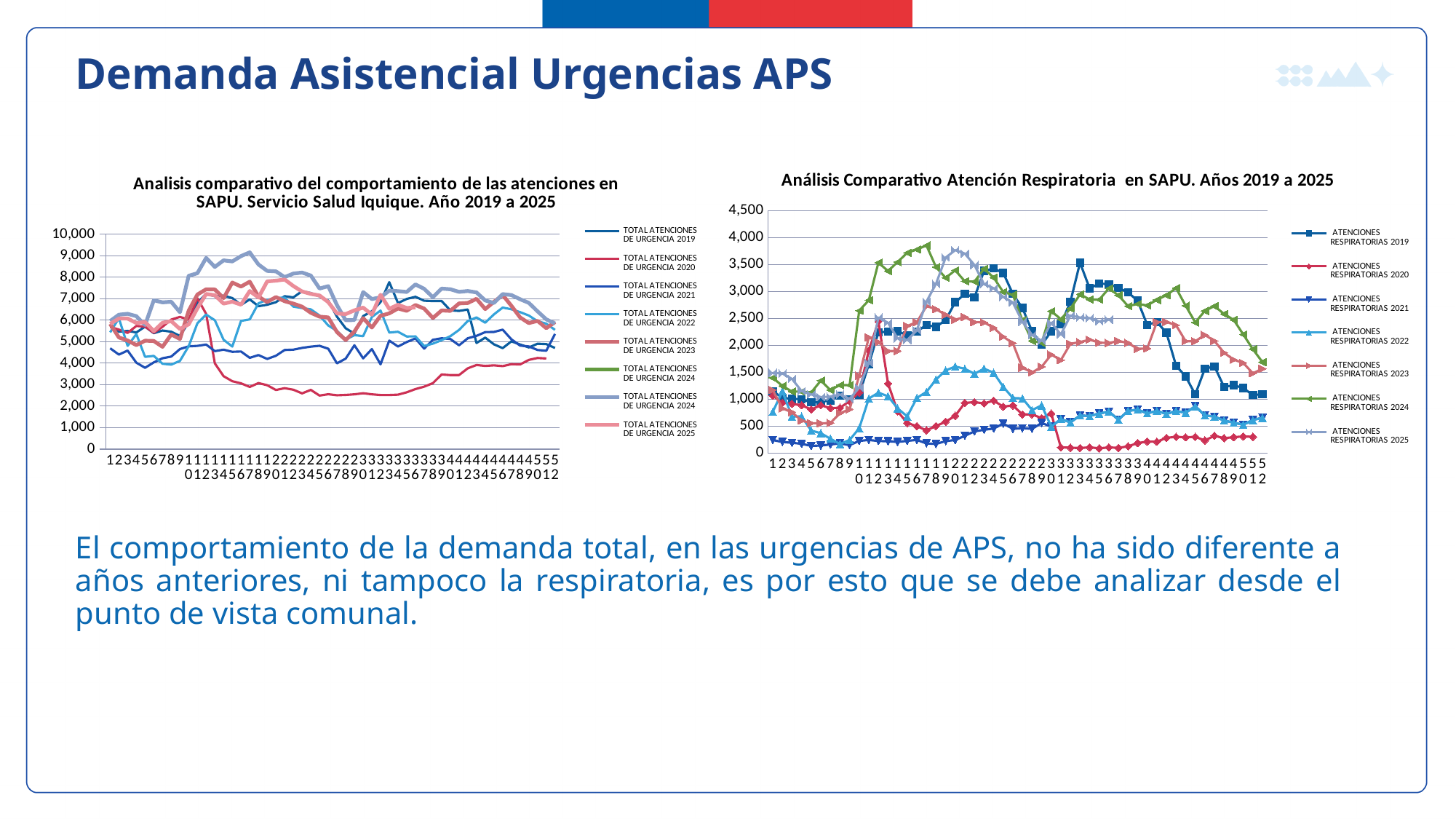
In the left chart, 'Analisis comparativo del comportamiento de las atenciones en SAPU', how many series does the legend list? 8 In the right chart, 'Análisis Comparativo Atención Respiratoria en SAPU', how many series does the legend list? 7 In the right chart, 'Análisis Comparativo Atención Respiratoria en SAPU', what is the highest value shown on the y axis? 4,500 In the right chart, 'Análisis Comparativo Atención Respiratoria en SAPU', is the peak value for ATENCIONES RESPIRATORIAS 2024 greater or less than 3,500? greater What kind of chart is the right chart, 'Análisis Comparativo Atención Respiratoria en SAPU'? Line chart In the right chart, 'Análisis Comparativo Atención Respiratoria en SAPU', how many points are on the x axis? 52 In the right chart, 'Análisis Comparativo Atención Respiratoria en SAPU', is the value for ATENCIONES RESPIRATORIAS 2021 at point 1 greater or less than 500? less In the right chart, 'Análisis Comparativo Atención Respiratoria en SAPU', is the value for ATENCIONES RESPIRATORIAS 2020 at point 40 greater or less than 500? less What kind of chart is the left chart, 'Analisis comparativo del comportamiento de las atenciones en SAPU'? Line chart In the left chart, 'Analisis comparativo del comportamiento de las atenciones en SAPU', what is the highest value shown on the y axis? 10,000 In the left chart, 'Analisis comparativo del comportamiento de las atenciones en SAPU', does the TOTAL ATENCIONES DE URGENCIA 2020 series rise or fall between point 10 and point 25? Fall